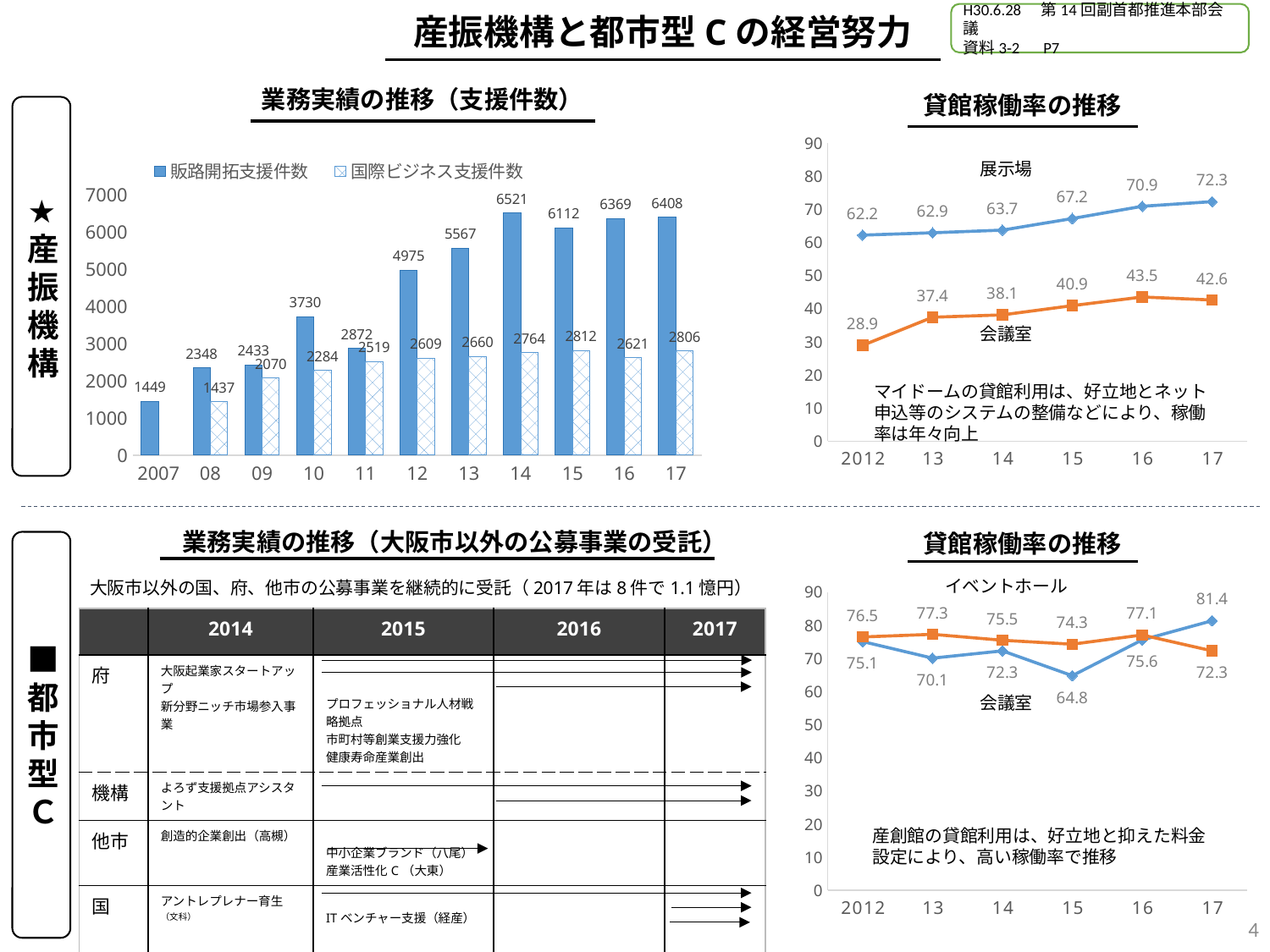
What kind of chart is 業務実績の推移（支援件数）? Bar chart In the bar chart 業務実績の推移（支援件数）, which year has the lowest 販路開拓支援件数? 2007 In the bar chart 業務実績の推移（支援件数）, how many series does the legend list? 2 In the bar chart 業務実績の推移（支援件数）, what is the difference between 販路開拓支援件数 and 国際ビジネス支援件数 in 2017? 3602 In the top-right chart 貸館稼働率の推移, what is the value for 展示場 in 2017? 72.3 In the top-right chart 貸館稼働率の推移, what is the value for 会議室 in 2012? 28.9 In the top-right chart 貸館稼働率の推移, does the 展示場 line rise or fall from 2012 to 2017? Rises In the bar chart 業務実績の推移（支援件数）, what is the value of 販路開拓支援件数 for 2014? 6521 In the bar chart 業務実績の推移（支援件数）, how many years are shown on the x axis? 11 In the bar chart 業務実績の推移（支援件数）, which year has the highest 販路開拓支援件数? 2014 In the bottom-right chart 貸館稼働率の推移, what is the lowest value plotted on the blue line? 64.8 In the bar chart 業務実績の推移（支援件数）, what is the value of 国際ビジネス支援件数 for 2017? 2806